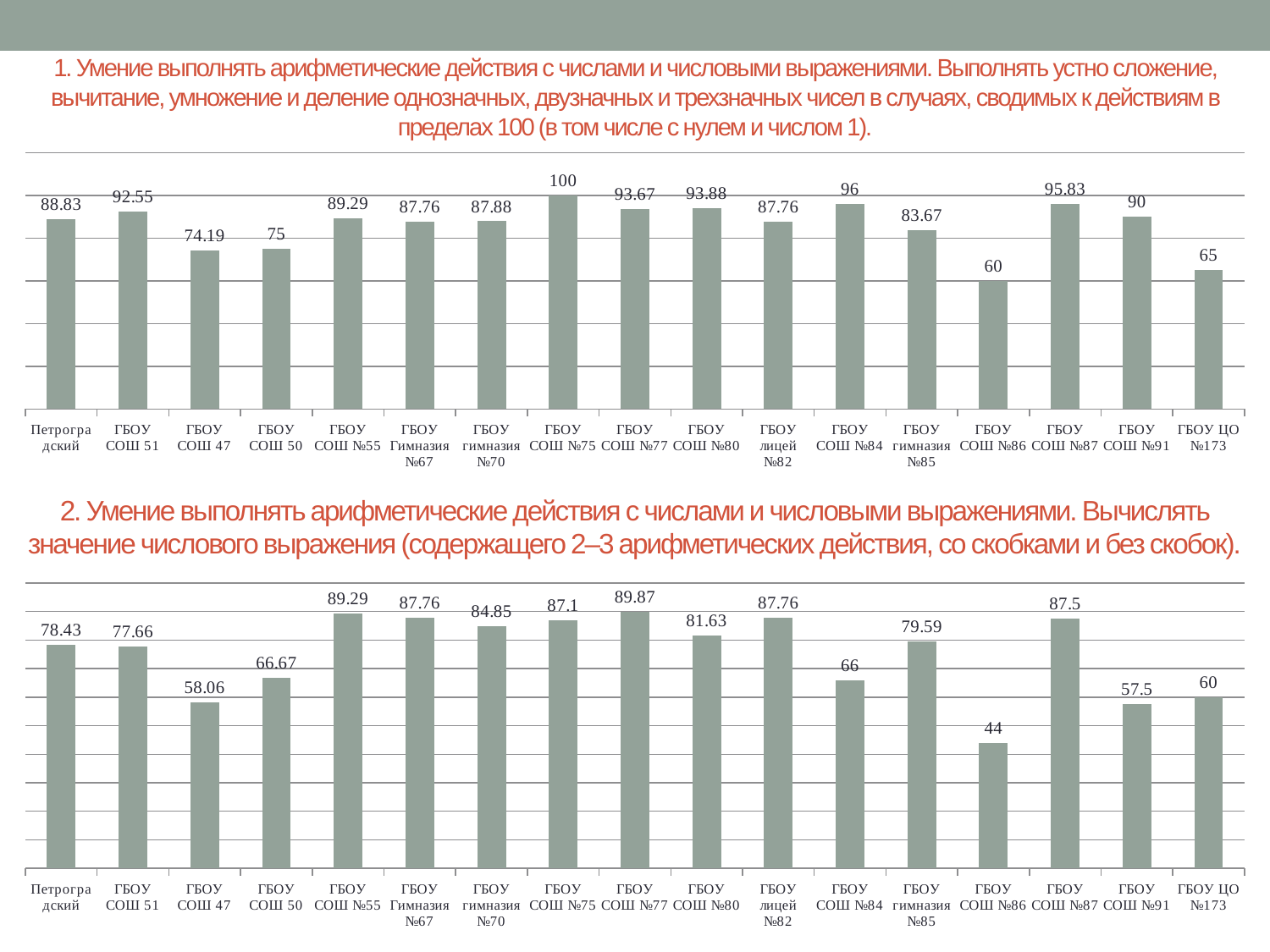
In the bottom chart, which category has the highest value? ГБОУ СОШ №77 In the top chart, what is the value for ГБОУ СОШ №75? 100 In the top chart, what is the difference between the values for ГБОУ СОШ №84 and ГБОУ ЦО №173? 31 In the top chart, what is the value for ГБОУ СОШ №86? 60 What type of chart is the top chart? Bar chart In the top chart, which category has the lowest value? ГБОУ СОШ №86 In the top chart, which is larger: the value for ГБОУ СОШ 47 or ГБОУ СОШ 50? ГБОУ СОШ 50 In the bottom chart, what is the difference between the values for ГБОУ СОШ №87 and ГБОУ СОШ №91? 30 How many categories are shown in the bottom chart? 17 In the bottom chart, which category has the lowest value? ГБОУ СОШ №86 In the bottom chart, what is the value for Петроградский? 78.43 In the bottom chart, what is the value for ГБОУ СОШ №86? 44